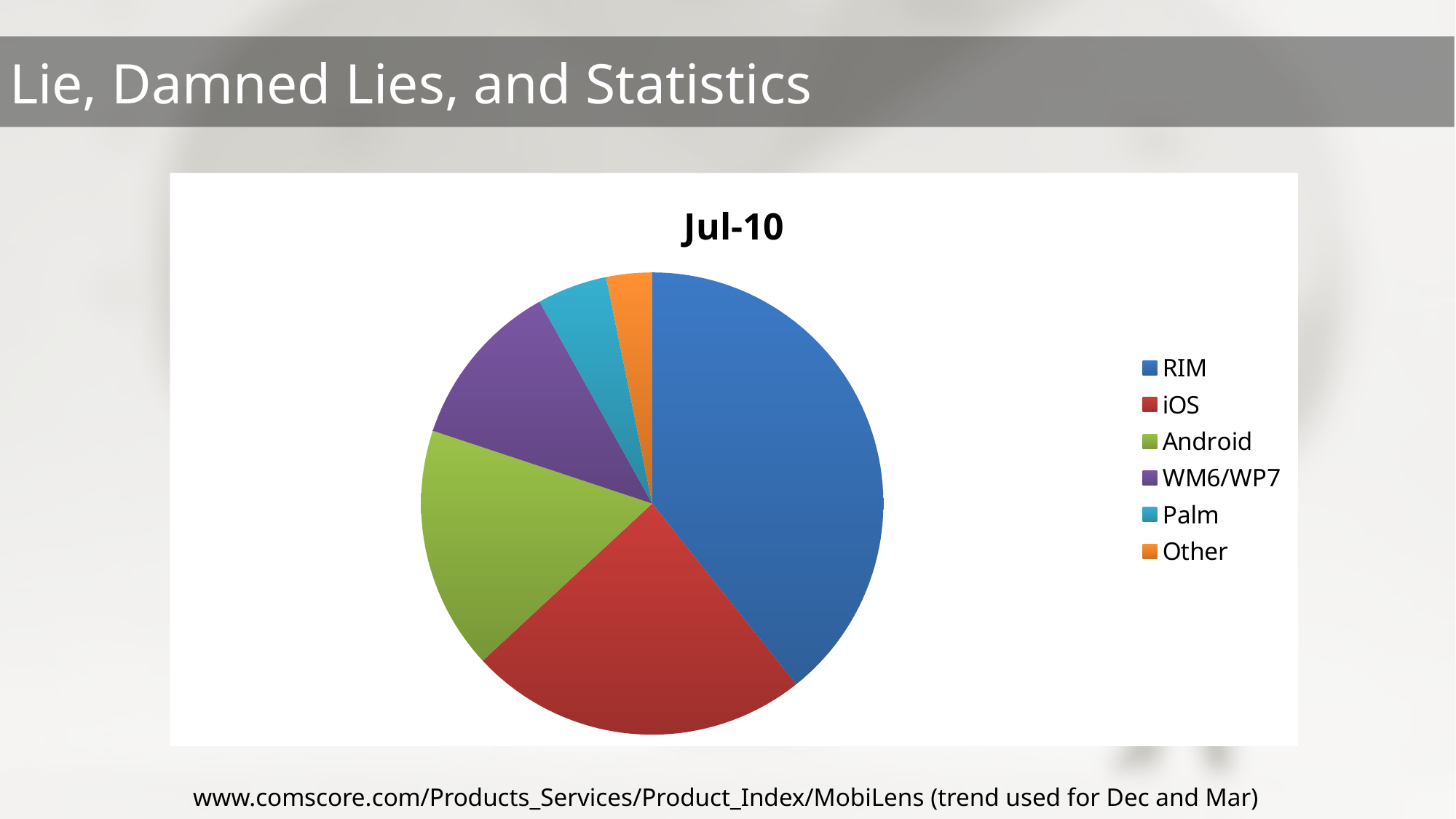
Which slice is larger, RIM or iOS? RIM Which slice is larger, iOS or Android? iOS Which category has the largest slice of the pie? RIM Which slice is larger, Android or WM6/WP7? Android Which category is shown in green in the pie chart? Android How many entries does the legend list? 6 What kind of chart is shown on the slide? Pie chart How many slices does the pie chart have? 6 What is the title of the chart? Jul-10 Which category has the smallest slice of the pie? Other